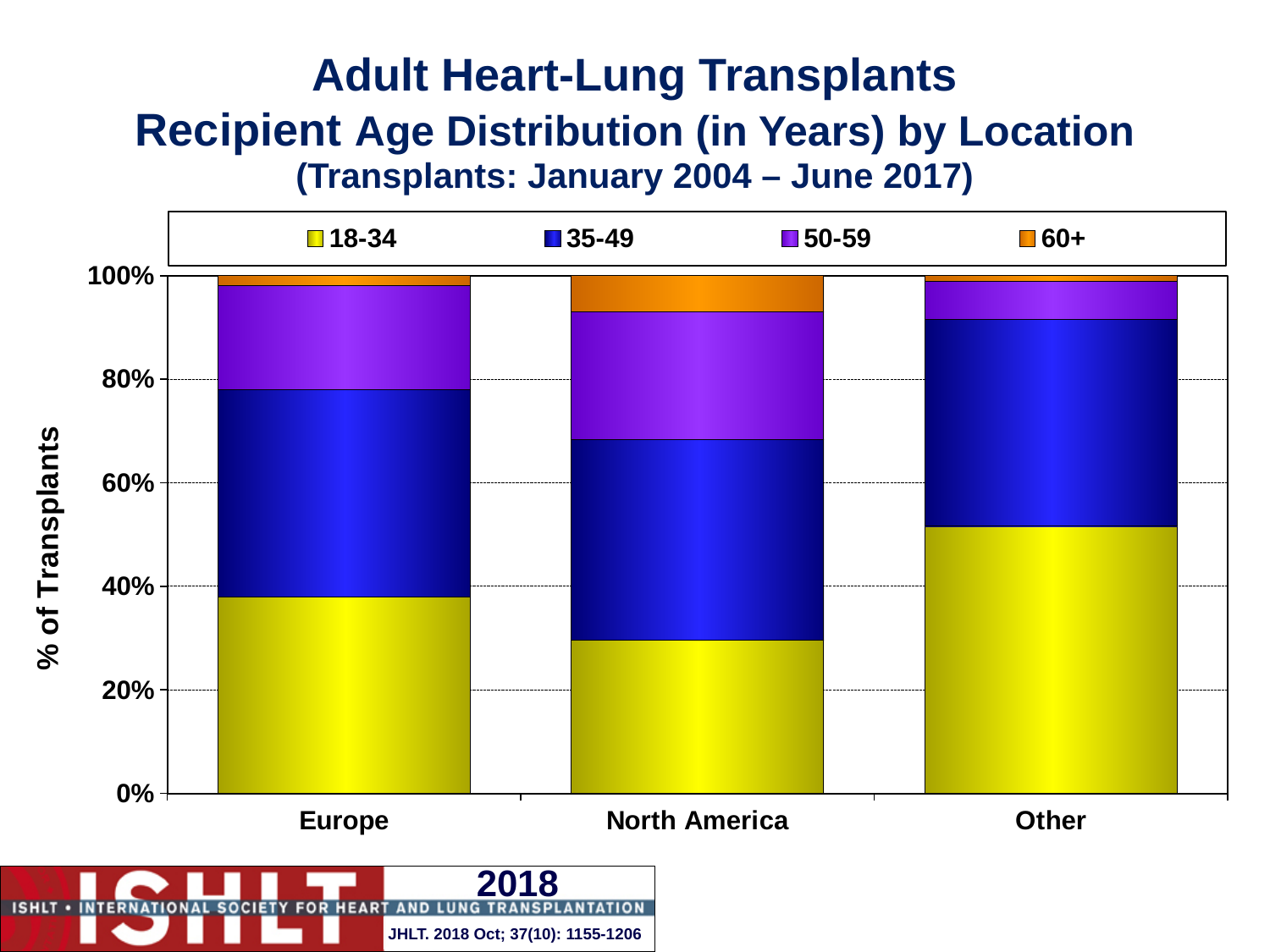
Which location has the smallest share of recipients aged 50-59? Other Is the share of recipients aged 18-34 in North America greater or less than 40%? less Which has a larger share of recipients aged 18-34, Europe or North America? Europe How many locations are shown on the x axis of the chart? 3 Which location has the largest share of recipients aged 18-34? Other How many age groups does the legend list? 4 Is the share of recipients aged 18-34 in Other greater or less than 40%? greater Which location has the largest share of recipients aged 60+? North America Which location has the smallest share of recipients aged 18-34? North America What is the total height of each stacked bar on the y axis? 100% What kind of chart is shown on the slide? Stacked bar chart What is the label on the y axis of the chart? % of Transplants